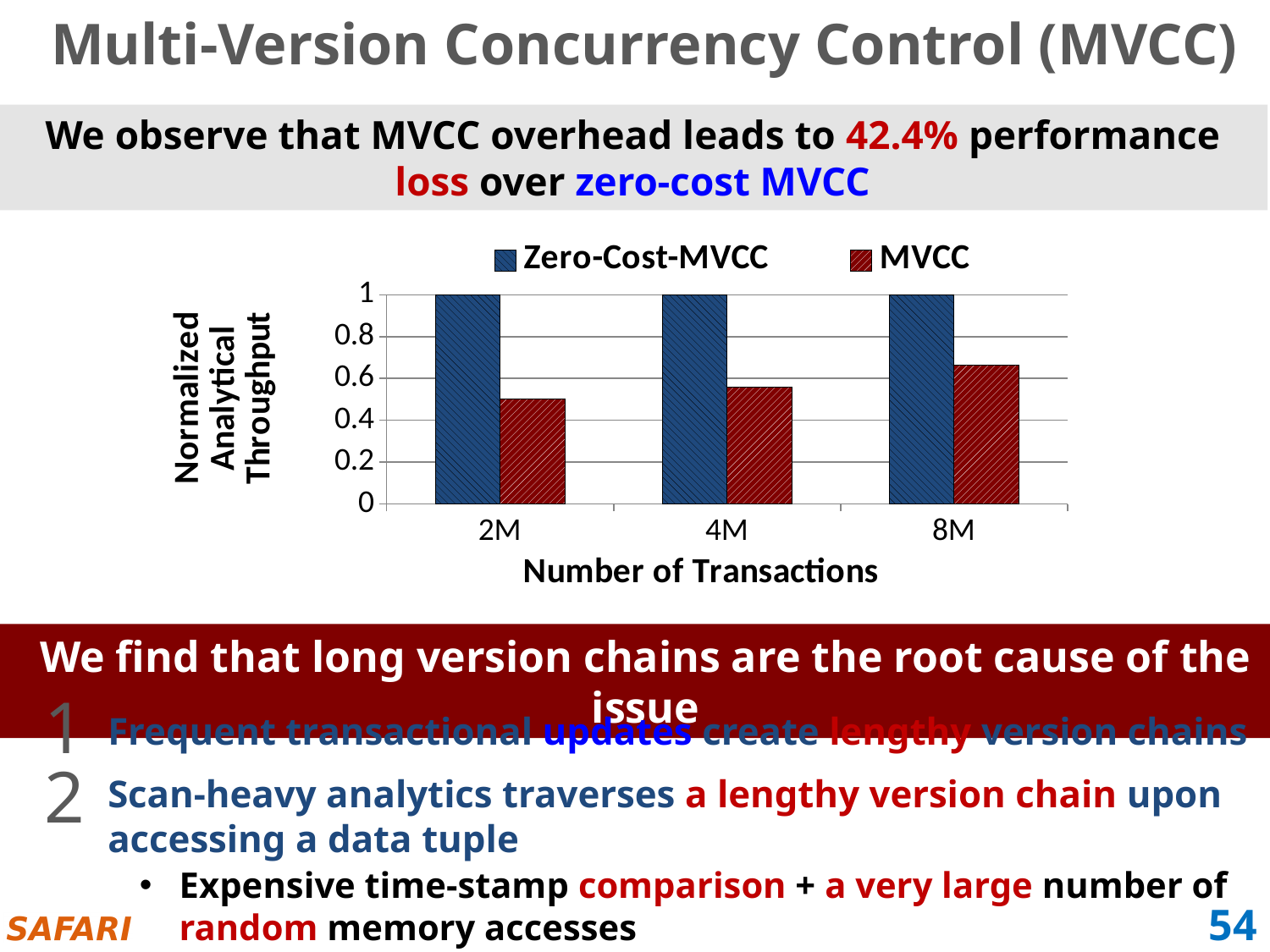
What kind of chart is shown on the slide? bar chart Is the MVCC value at 4M transactions greater or less than 0.4? greater How many series does the chart legend list? 2 Is the MVCC value at 2M transactions greater or less than 0.6? less At which number of transactions is the MVCC throughput highest? 8M Is the MVCC value at 8M transactions greater or less than 0.6? greater At which number of transactions is the MVCC throughput lowest? 2M How many categories are shown on the x axis of the chart? 3 What is the Normalized Analytical Throughput for Zero-Cost-MVCC at 2M transactions? 1 At 2M transactions, which series has the larger value, Zero-Cost-MVCC or MVCC? Zero-Cost-MVCC What is the Normalized Analytical Throughput for Zero-Cost-MVCC at 8M transactions? 1 Do the MVCC values rise or fall as the number of transactions increases from 2M to 8M? rise